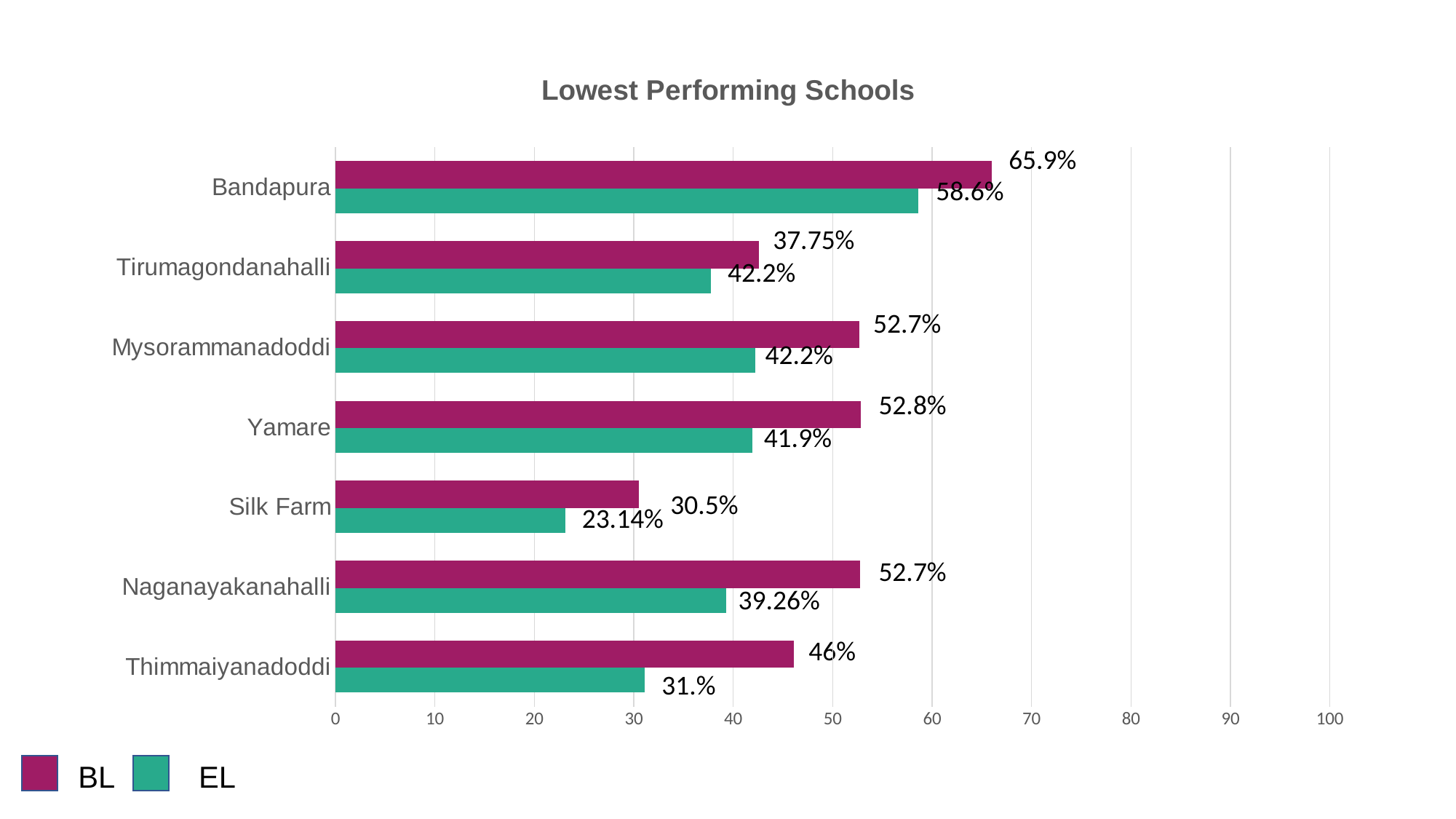
Which school has the lowest EL value? Silk Farm Which school has the highest BL value? Bandapura What is the title of the chart? Lowest Performing Schools What is the EL value for Silk Farm? 23.14% For Yamare, which is larger, the BL value or the EL value? BL What is the BL value for Bandapura? 65.9% What is the EL value for Naganayakanahalli? 39.26% How many schools are shown on the chart? 7 What is the difference between the BL and EL values for Bandapura? 7.3 percentage points What kind of chart is shown on the slide? Bar chart How many series does the legend list? 2 Is the EL value for Mysorammanadoddi greater or less than 50? less